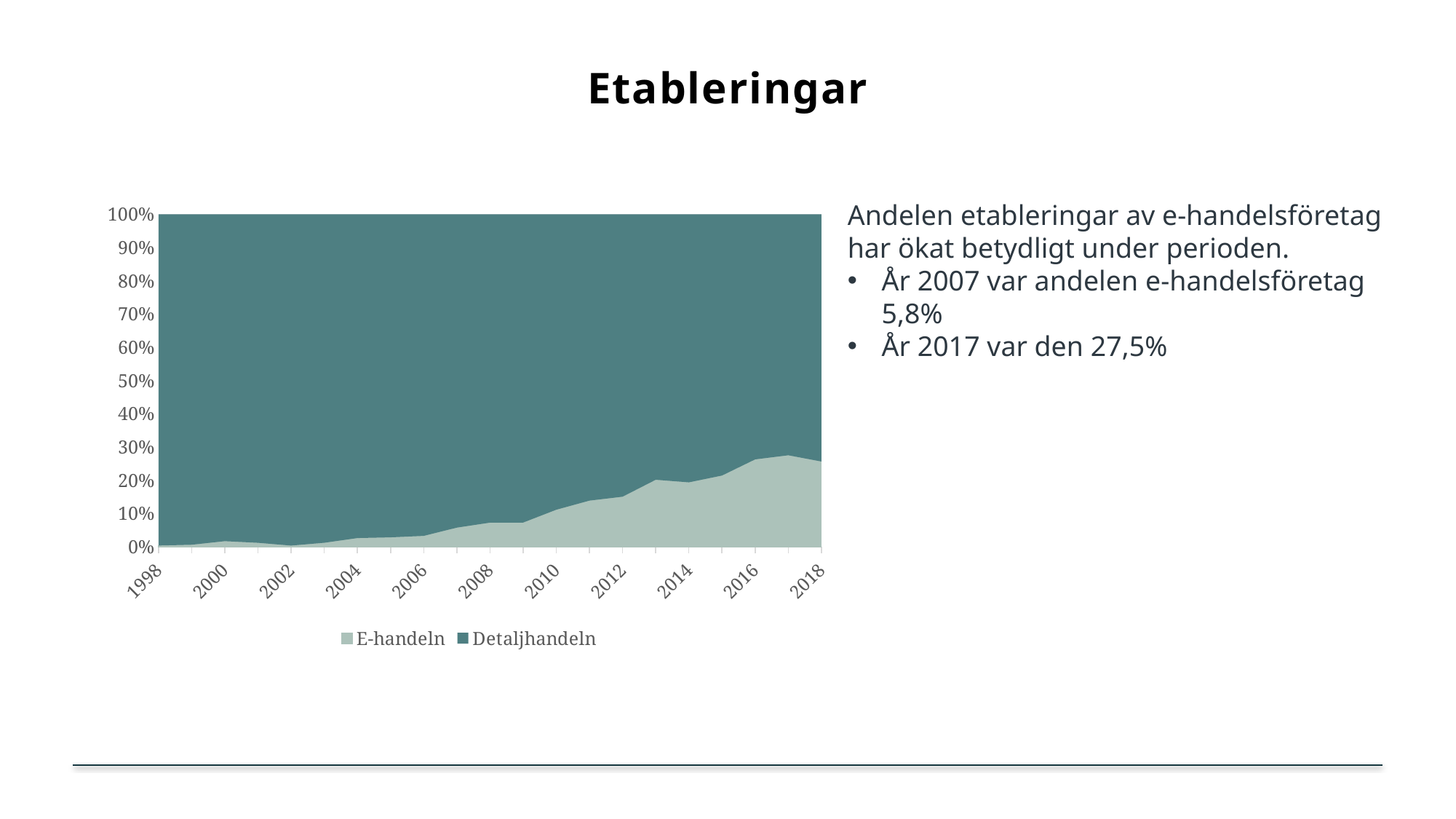
In 2018, which series has the larger share, E-handeln or Detaljhandeln? Detaljhandeln Is the value for E-handeln in 2010 greater or less than 20%? less Does the share for E-handeln rise or fall from 1998 to 2018? Rise What kind of chart is shown on the slide? Stacked area chart How many year labels are shown on the x axis? 11 What are the two series named in the legend? E-handeln and Detaljhandeln What is the title of the slide containing the chart? Etableringar Is the value for E-handeln in 2018 greater or less than 20%? greater According to the slide, what was the share of e-handelsföretag in 2017? 27,5% Does the share for Detaljhandeln rise or fall from 1998 to 2018? Fall How many series does the legend list? 2 Is the value for Detaljhandeln in 2018 greater or less than 70%? greater